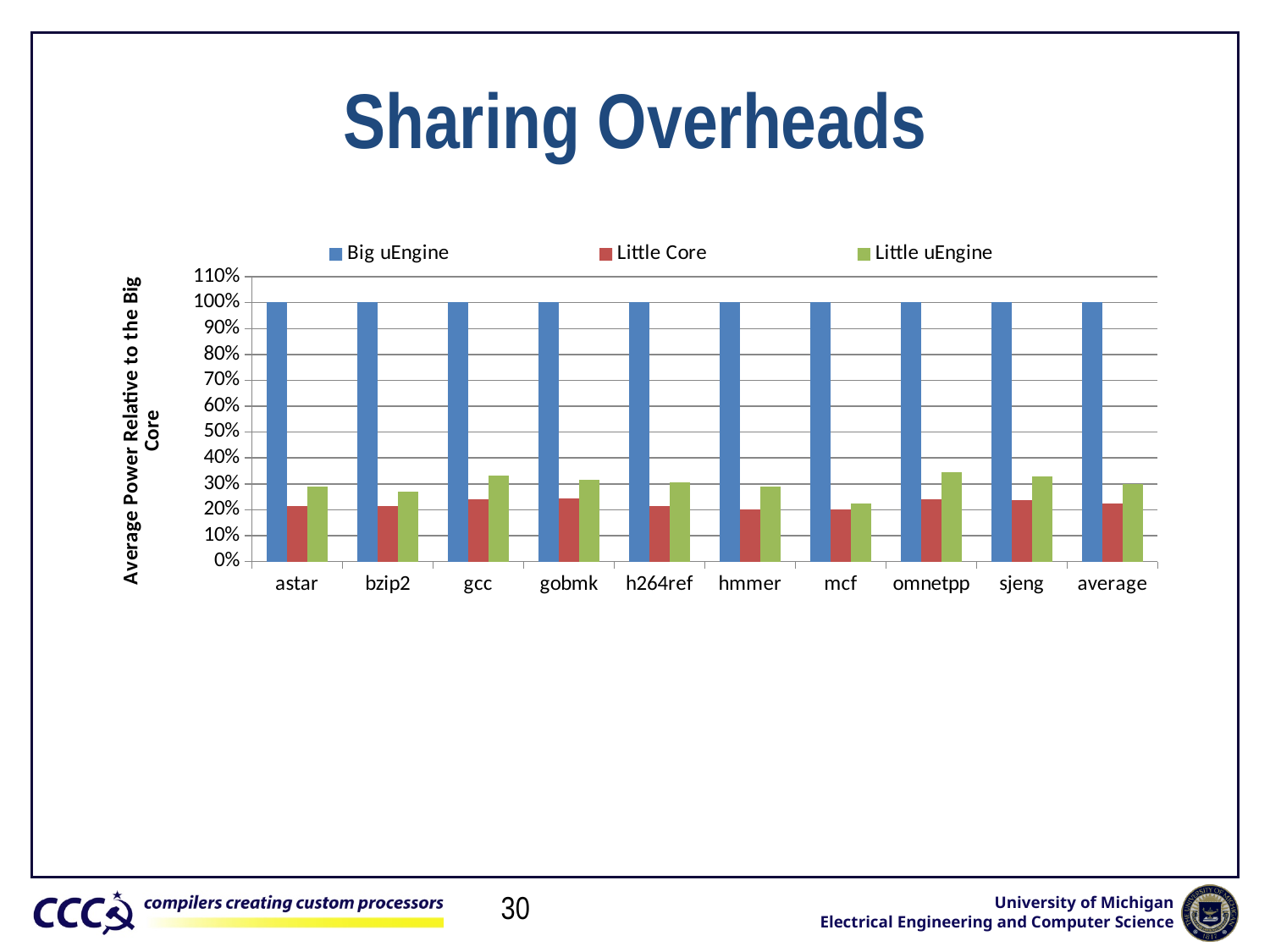
What kind of chart is shown on the slide? bar chart What colour represents Little Core in the legend? red How many series does the legend list? 3 Is the value of Little uEngine for omnetpp greater or less than 30%? greater For gcc, which is larger: Little Core or Little uEngine? Little uEngine What is the title of the y axis? Average Power Relative to the Big Core Is the value of Little Core for mcf greater or less than 30%? less What is the value of Big uEngine for astar? 100% Is the value of Little Core for omnetpp greater or less than 30%? less Which benchmark has the lowest Little uEngine value? mcf What is the value of Big uEngine for average? 100% How many benchmark categories are shown on the x axis? 10